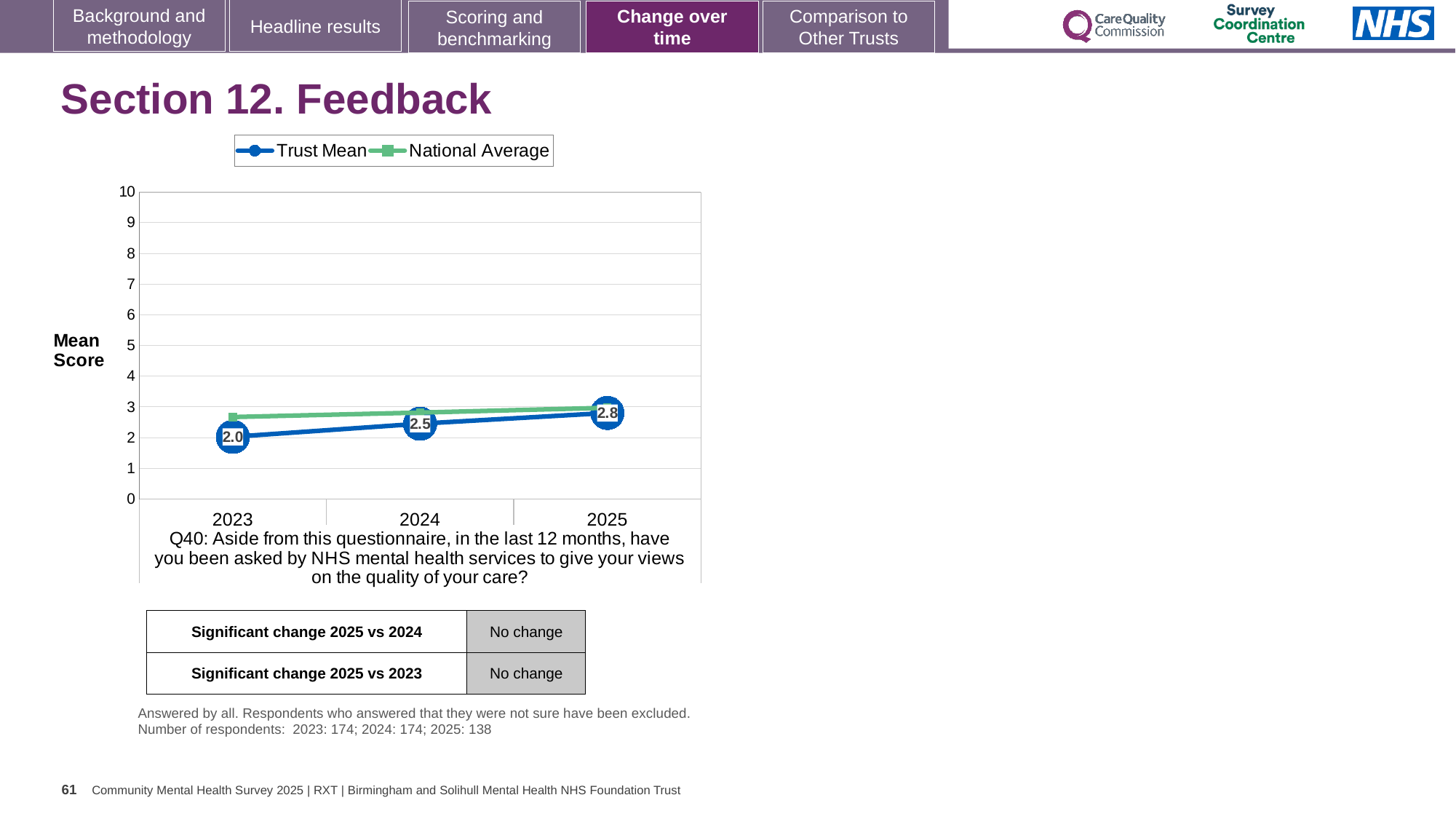
What is the difference between the Trust Mean scores for 2025 and 2023? 0.8 What kind of chart is shown? Line chart How many series does the legend list? 2 What is the Trust Mean score for 2024? 2.5 What is the Trust Mean score for 2025? 2.8 Which is larger in 2023, the Trust Mean or the National Average? National Average In which year is the Trust Mean score highest? 2025 Does the Trust Mean rise or fall from 2023 to 2025? Rise In which year is the Trust Mean score lowest? 2023 Is the National Average value for 2023 greater or less than 2? greater What is the Trust Mean score for 2023? 2.0 How many years are shown on the x axis? 3